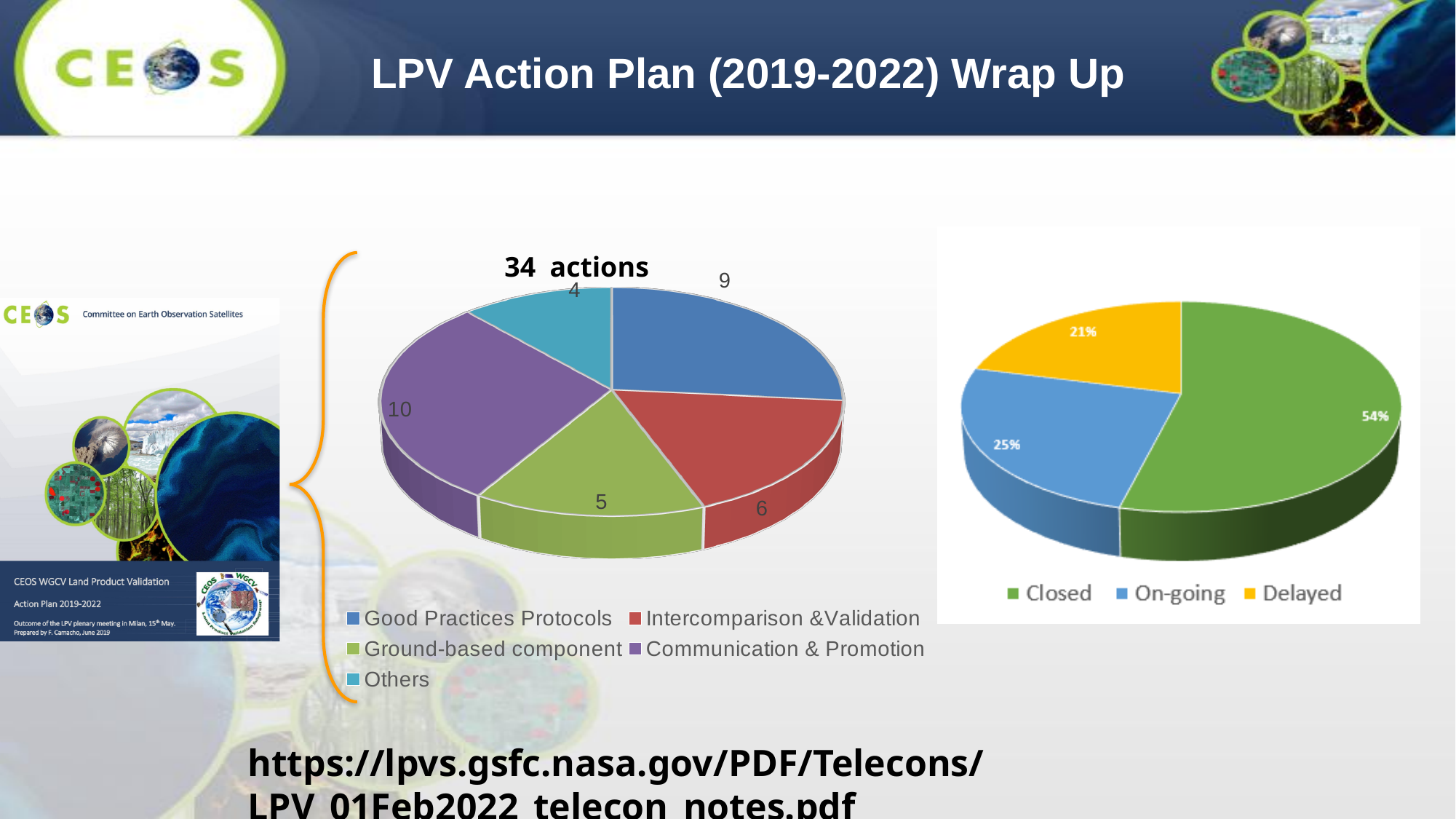
What type of chart is the '34 actions' chart? Pie chart How many categories does the legend of the '34 actions' pie chart list? 5 In the '34 actions' pie chart, which is larger: Intercomparison & Validation or Ground-based component? Intercomparison & Validation In the '34 actions' pie chart, what is the difference between the Communication & Promotion and Ground-based component values? 5 In the right-hand pie chart, what percentage of actions are Closed? 54% In the '34 actions' pie chart, which category has the most actions? Communication & Promotion In the right-hand pie chart, what is the difference between the On-going and Delayed shares? 4% In the right-hand pie chart, which colour represents the Closed category? Green In the '34 actions' pie chart, how many actions are in the Good Practices Protocols category? 9 In the '34 actions' pie chart, how many actions are in the Communication & Promotion category? 10 In the right-hand pie chart, what percentage of actions are Delayed? 21% In the '34 actions' pie chart, which category has the fewest actions? Others